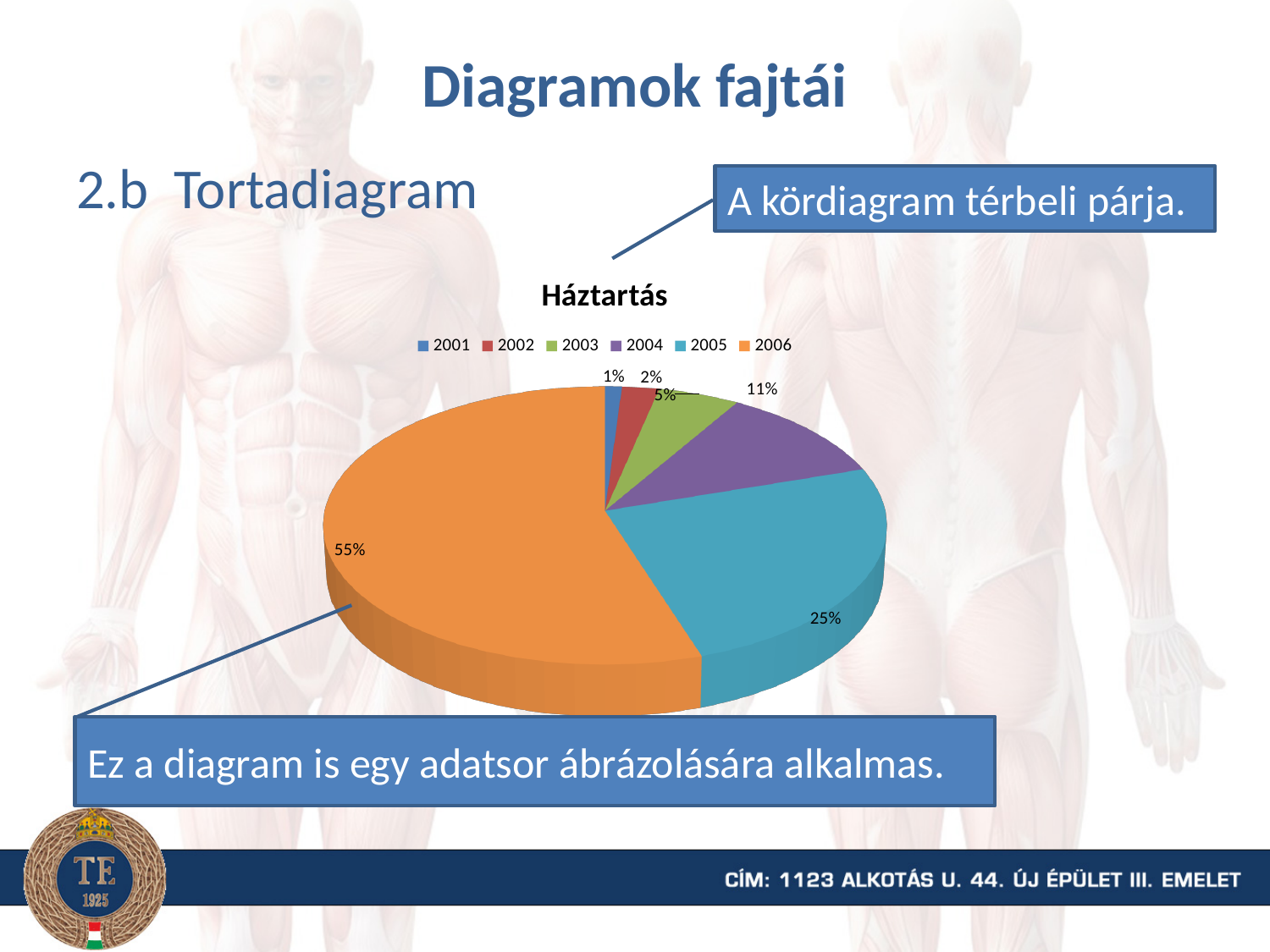
Which has a larger share, 2003 or 2004? 2004 What share of the pie does 2001 have? 1% What share of the pie does 2006 have? 55% What share of the pie does 2005 have? 25% Which year has the smallest slice of the pie? 2001 What is the difference between the shares of 2006 and 2005? 30% How many entries does the chart's legend list? 6 How many slices does the pie chart have? 6 Which year has the largest slice of the pie? 2006 What type of chart is shown on the slide? pie chart What is the title of the chart? Háztartás